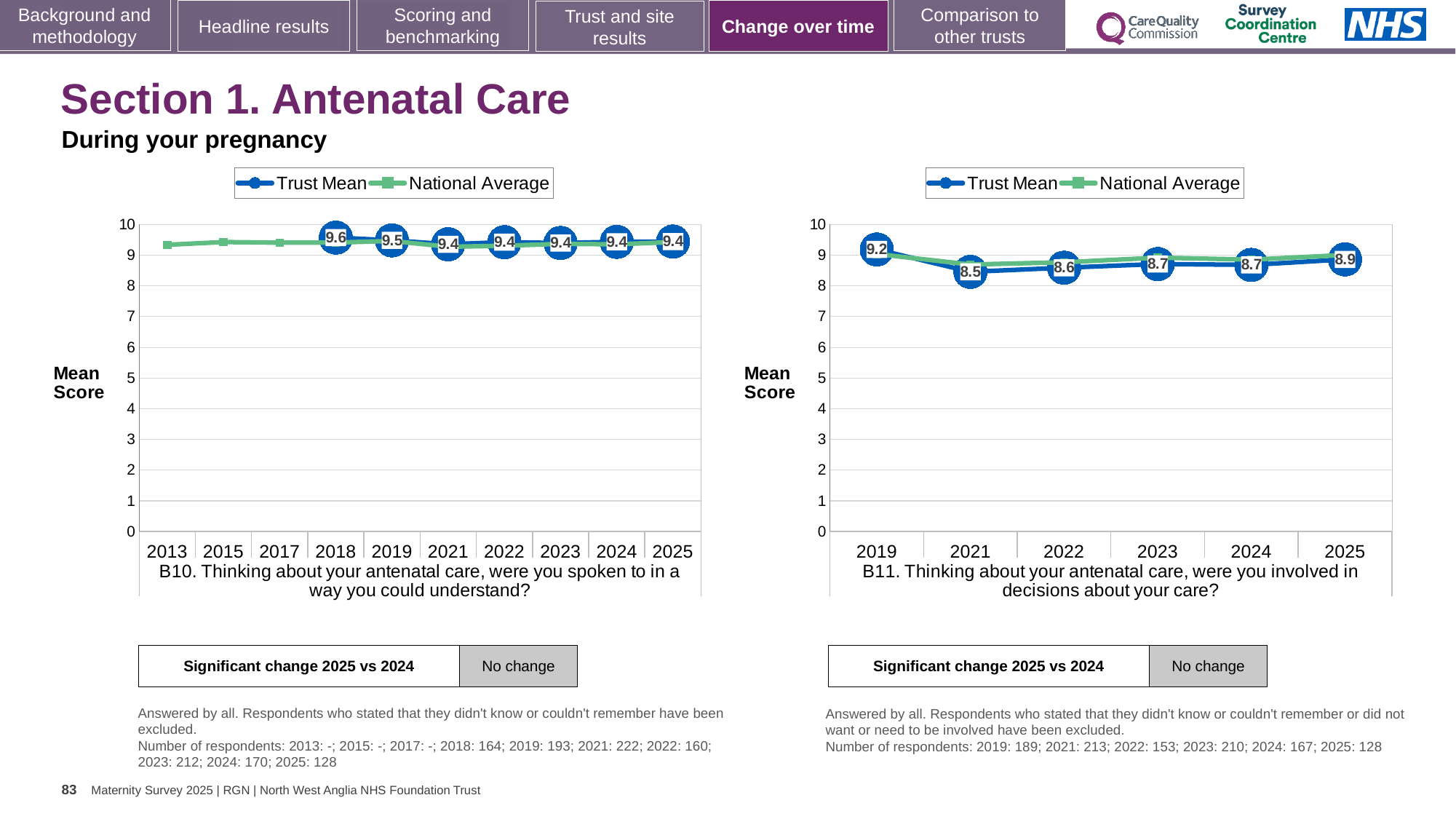
In the B11 chart on the right, is the Trust Mean for 2021 greater or less than 9? less In the B11 chart on the right, how many series does the legend list? 2 In the B11 chart on the right, which year has the lowest Trust Mean? 2021 In the B10 chart on the left, how many years are shown on the x axis? 10 In the B11 chart on the right, what is the Trust Mean for 2025? 8.9 In the B11 chart on the right, what is the Trust Mean for 2019? 9.2 What type of chart is the B11 chart on the right? Line chart In the B10 chart on the left, what is the Trust Mean for 2018? 9.6 In the B10 chart on the left, what is the difference between the Trust Mean for 2018 and for 2025? 0.2 In the B11 chart on the right, what is the difference between the Trust Mean for 2019 and for 2021? 0.7 In the B11 chart on the right, which year has the highest Trust Mean? 2019 In the B10 chart on the left, what is the Trust Mean for 2025? 9.4